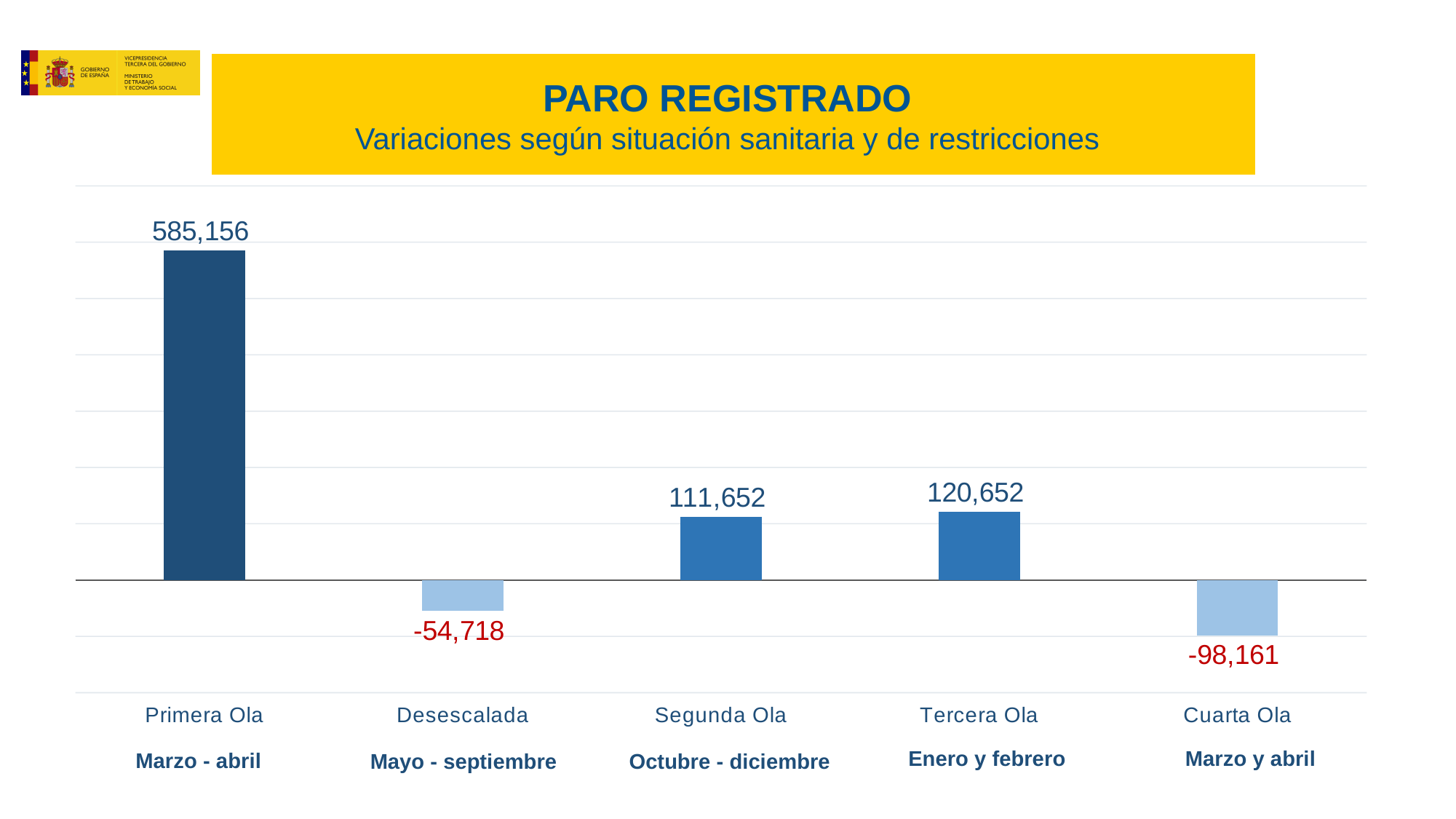
What is the difference between the values for Tercera Ola and Segunda Ola? 9,000 Which is larger, the value for Tercera Ola or the value for Segunda Ola? Tercera Ola How many categories are shown in the chart? 5 What kind of chart is shown on the slide? Bar chart Which category has the lowest value? Cuarta Ola What is the difference between the values for Primera Ola and Tercera Ola? 464,504 What is the value for Desescalada? -54,718 What is the value for Cuarta Ola? -98,161 What is the value for Primera Ola? 585,156 What is the value for Segunda Ola? 111,652 Which category has the highest value? Primera Ola What is the main title of the chart? PARO REGISTRADO